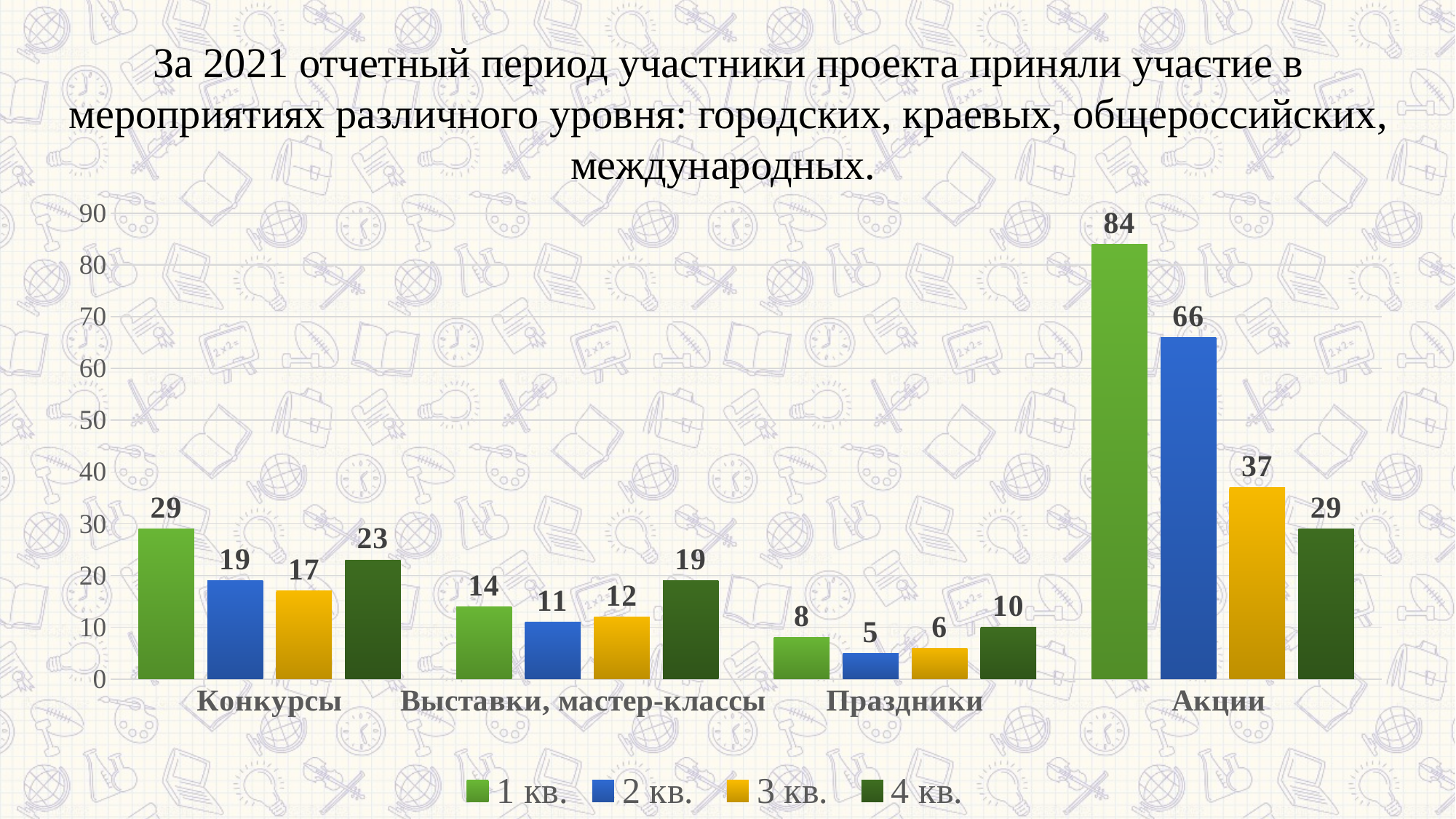
Which is larger: the 4 кв. value for Конкурсы or the 4 кв. value for Выставки, мастер-классы? Конкурсы What is the difference between the 1 кв. and 2 кв. values in the Акции category? 18 What is the value for 2 кв. in the Праздники category? 5 What is the value for 4 кв. in the Выставки, мастер-классы category? 19 Which category has the highest value for 2 кв.? Акции How many categories are shown on the x axis? 4 How many series does the legend list? 4 What colour are the bars for the 3 кв. series? Yellow What is the value for 1 кв. in the Акции category? 84 What is the value for 3 кв. in the Конкурсы category? 17 Which category has the lowest value for 1 кв.? Праздники What kind of chart is shown on the slide? Bar chart